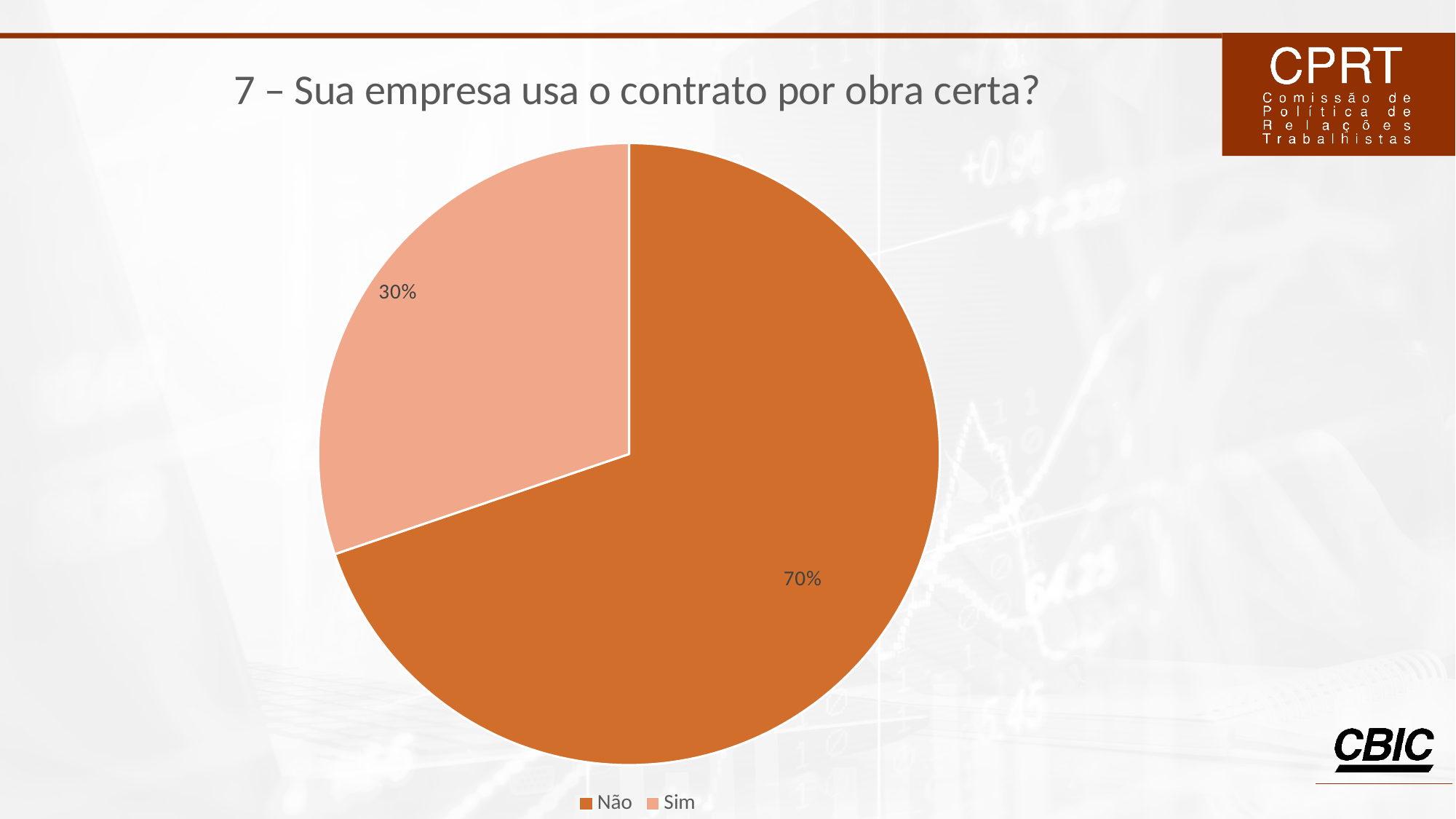
What percentage of the pie chart corresponds to "Não"? 70% What is the title of the chart on the slide? 7 – Sua empresa usa o contrato por obra certa? Which slice is larger, "Não" or "Sim"? Não How many entries does the legend list? 2 Which legend entry is shown in the darker orange colour? Não Which category has the smallest slice of the pie chart? Sim Which category has the largest slice of the pie chart? Não What share of the pie does the "Sim" slice represent? 30% What is the difference in percentage points between the "Não" and "Sim" slices? 40 What percentage of the pie chart corresponds to "Sim"? 30% How many slices does the pie chart have? 2 What kind of chart is shown on the slide? Pie chart